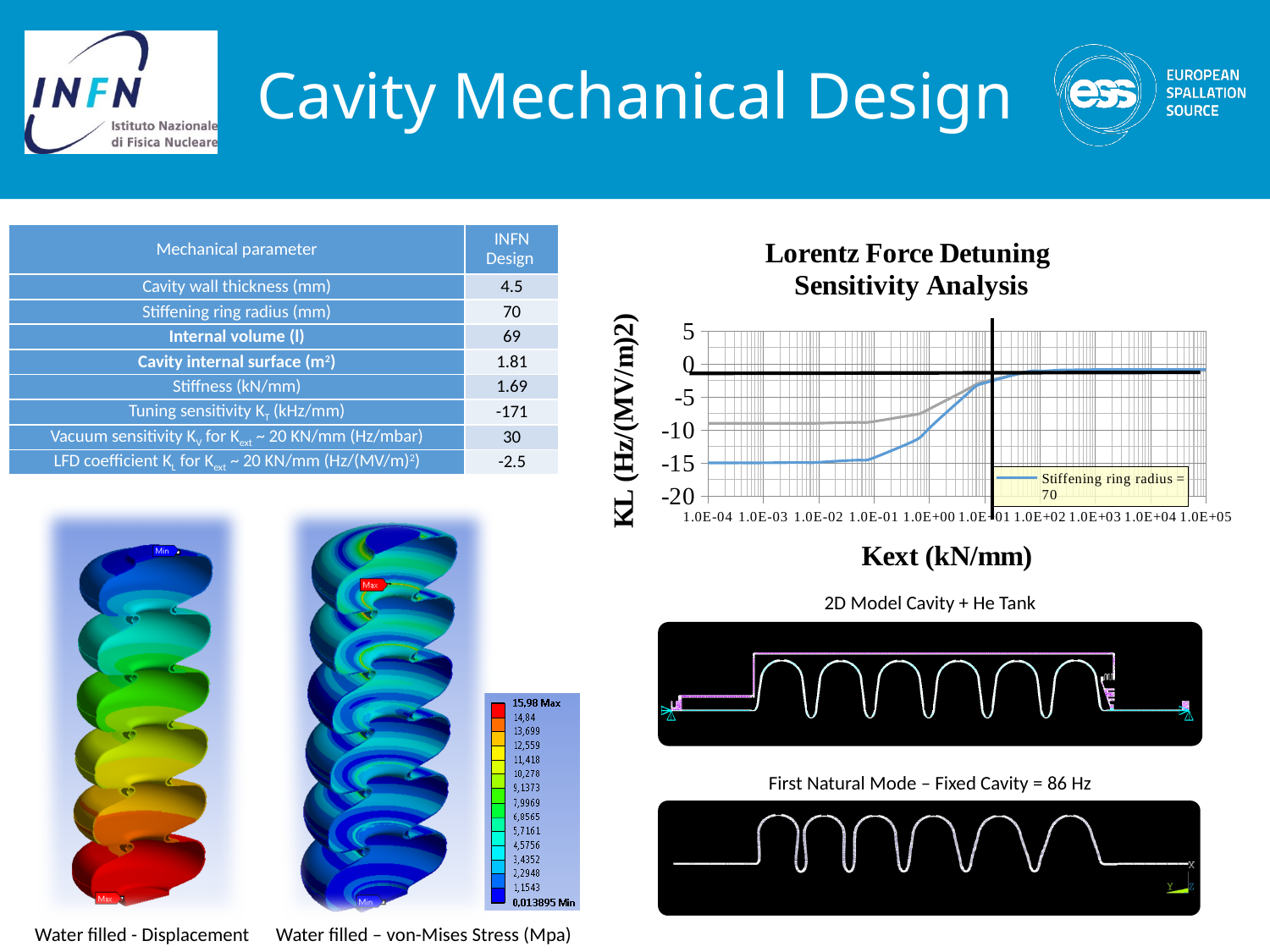
In the Lorentz Force Detuning Sensitivity Analysis chart, what is the lowest value shown on the y axis? -20 In the Lorentz Force Detuning Sensitivity Analysis chart, is the value of the gray line at Kext = 1.0E-03 greater or less than -15? greater In the Lorentz Force Detuning Sensitivity Analysis chart, at Kext = 1.0E-02, which line has the higher KL value, the blue line or the gray line? the gray line In the Lorentz Force Detuning Sensitivity Analysis chart, is the value of the blue line at Kext = 1.0E-04 greater or less than -10? less In the Lorentz Force Detuning Sensitivity Analysis chart, is the value of the blue line at Kext = 1.0E+05 greater or less than -5? greater In the Lorentz Force Detuning Sensitivity Analysis chart, what is the label of the x axis? Kext (kN/mm) What is the title of the chart on the right side of the slide? Lorentz Force Detuning Sensitivity Analysis What kind of chart is the Lorentz Force Detuning Sensitivity Analysis chart? line chart In the Lorentz Force Detuning Sensitivity Analysis chart, how many tick labels are shown on the x axis? 10 In the Lorentz Force Detuning Sensitivity Analysis chart, how many series does the legend list? 1 In the Lorentz Force Detuning Sensitivity Analysis chart, does the blue line rise or fall as Kext increases? rise